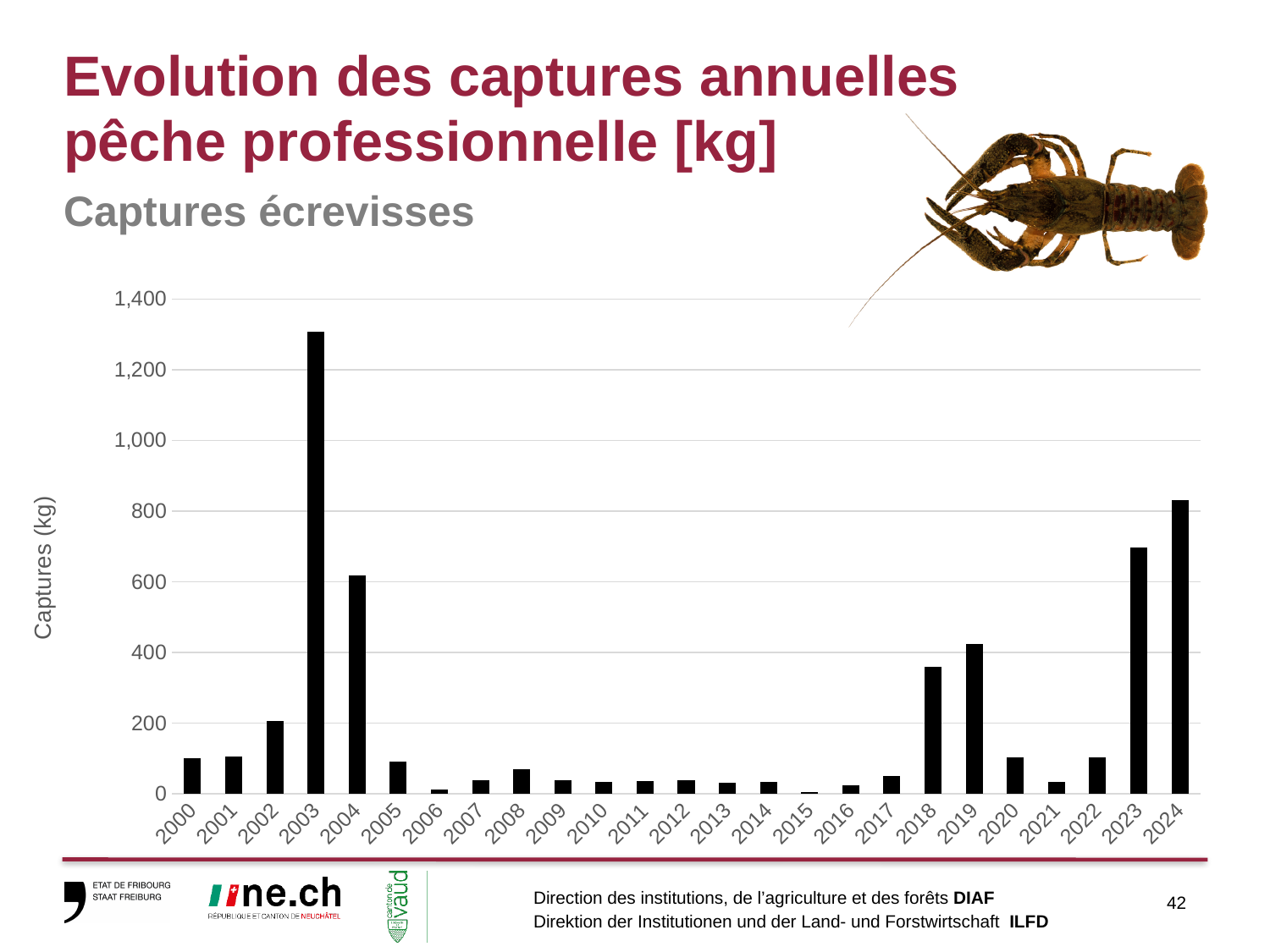
Which is larger, the value for 2024 or the value for 2023? 2024 What kind of chart is shown on the slide? bar chart What is the label of the y axis? Captures (kg) Is the value for 2019 greater or less than 400? greater Which year has the highest value for captures? 2003 Is the value for 2023 greater or less than 600? greater Is the value for 2024 greater or less than 800? greater Which is larger, the value for 2018 or the value for 2002? 2018 Which year has the lowest value for captures? 2015 How many years are shown on the x axis? 25